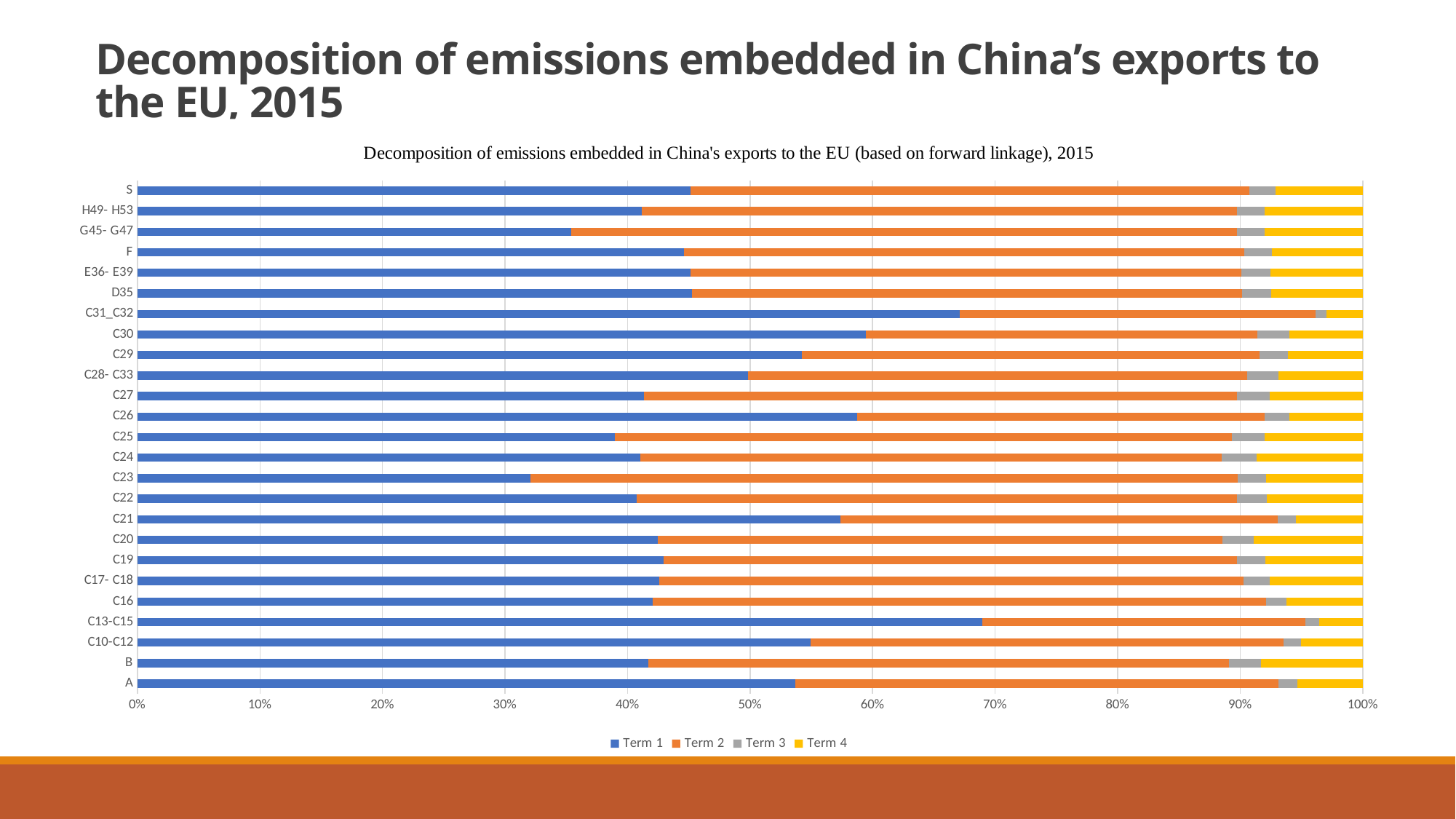
Is the Term 1 value for C13-C15 greater or less than 60%? greater Which legend entry is shown in yellow? Term 4 What is the total of the stacked bar for category A? 100% Which has the larger Term 1 share, C23 or C13-C15? C13-C15 How many categories are plotted on the vertical axis? 25 Is the Term 1 value for C23 greater or less than 40%? less What kind of chart is shown on the slide? Stacked bar chart Is the Term 1 value for G45- G47 greater or less than 40%? less Which category has the smallest Term 1 share? C23 How many series does the legend list? 4